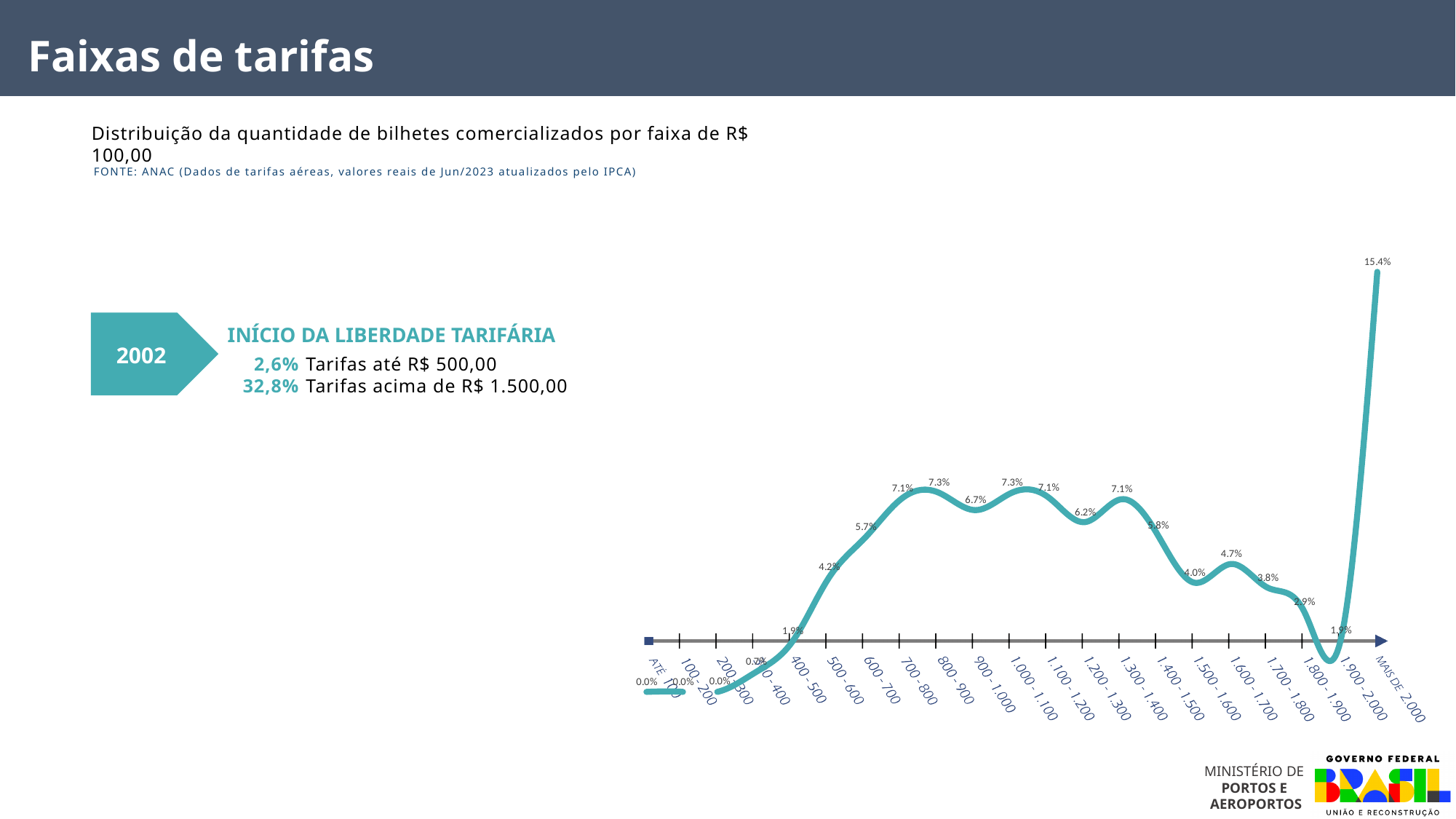
What kind of chart is shown on the slide? line chart What is the value for the MAIS DE 2.000 fare range? 15.4% What is the difference between the value for MAIS DE 2.000 and the value for 800 - 900? 8.1 percentage points Do the values rise or fall from the 300 - 400 range to the 800 - 900 range? rise Which is larger, the value for 700 - 800 or the value for 1.500 - 1.600? 700 - 800 What is the subtitle describing the chart's data? Distribuição da quantidade de bilhetes comercializados por faixa de R$ 100,00 What is the difference between the value for 600 - 700 and the value for 500 - 600? 1.5 percentage points What is the value for the 1.200 - 1.300 fare range? 6.2% Which fare range has the highest value? MAIS DE 2.000 What is the value for the 500 - 600 fare range? 4.2% How many fare ranges are plotted on the x axis? 21 What is the value for the 1.800 - 1.900 fare range? 2.9%